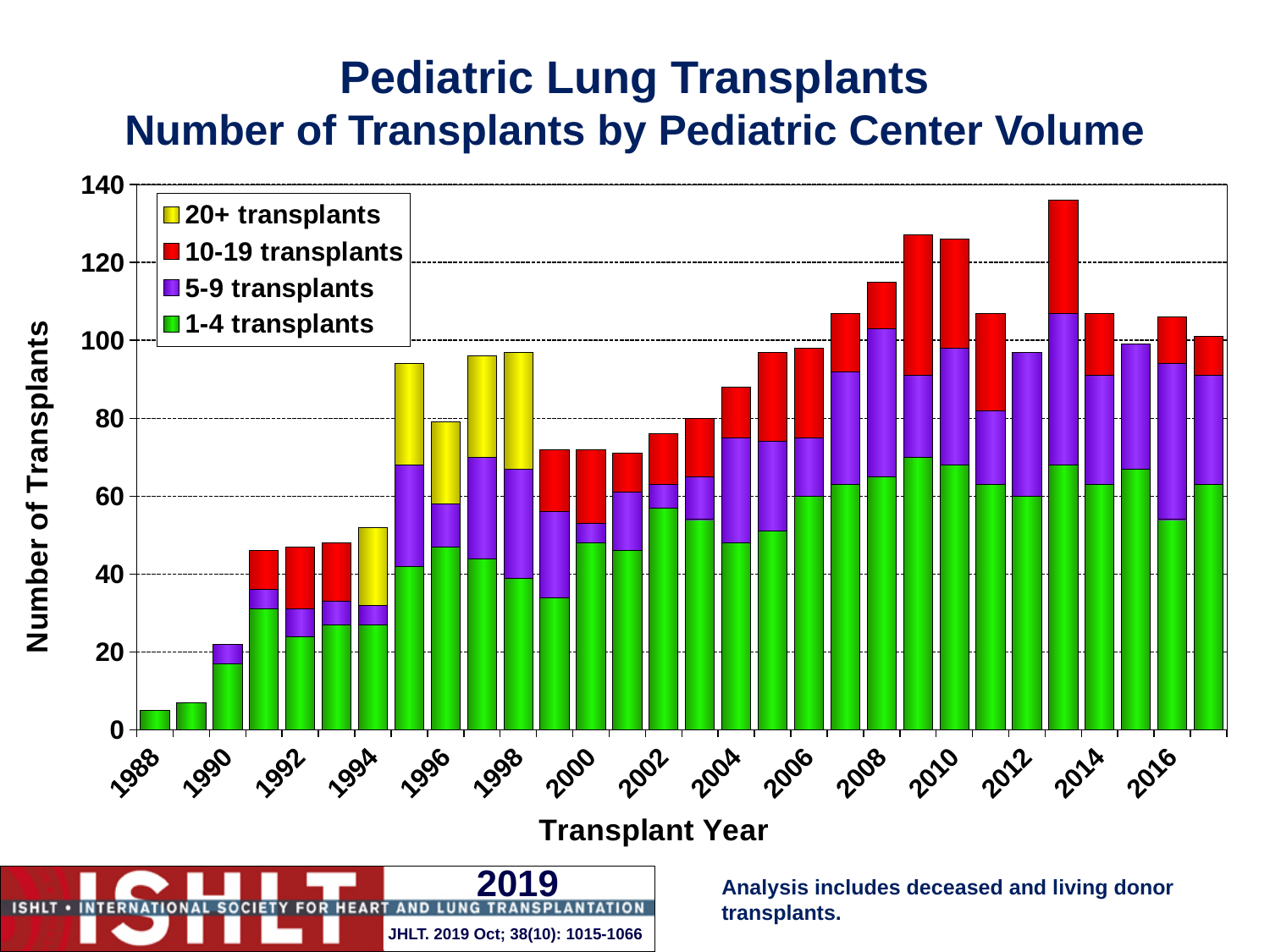
Which colour represents the '20+ transplants' series in the legend? Yellow How many transplant years (bars) are plotted on the chart? 30 Which year has a larger total number of transplants, 2012 or 2013? 2013 Which transplant year has the lowest total number of transplants? 1988 Is the total number of transplants for 2013 greater or less than 120? greater Do the total numbers of transplants generally rise or fall from 1988 to 2013? rise Is the total number of transplants for 2000 greater or less than 80? less Which transplant year has the highest total number of transplants? 2013 Is the total number of transplants for 2009 greater or less than 120? greater What kind of chart is shown on the slide? Stacked bar chart How many series does the legend list? 4